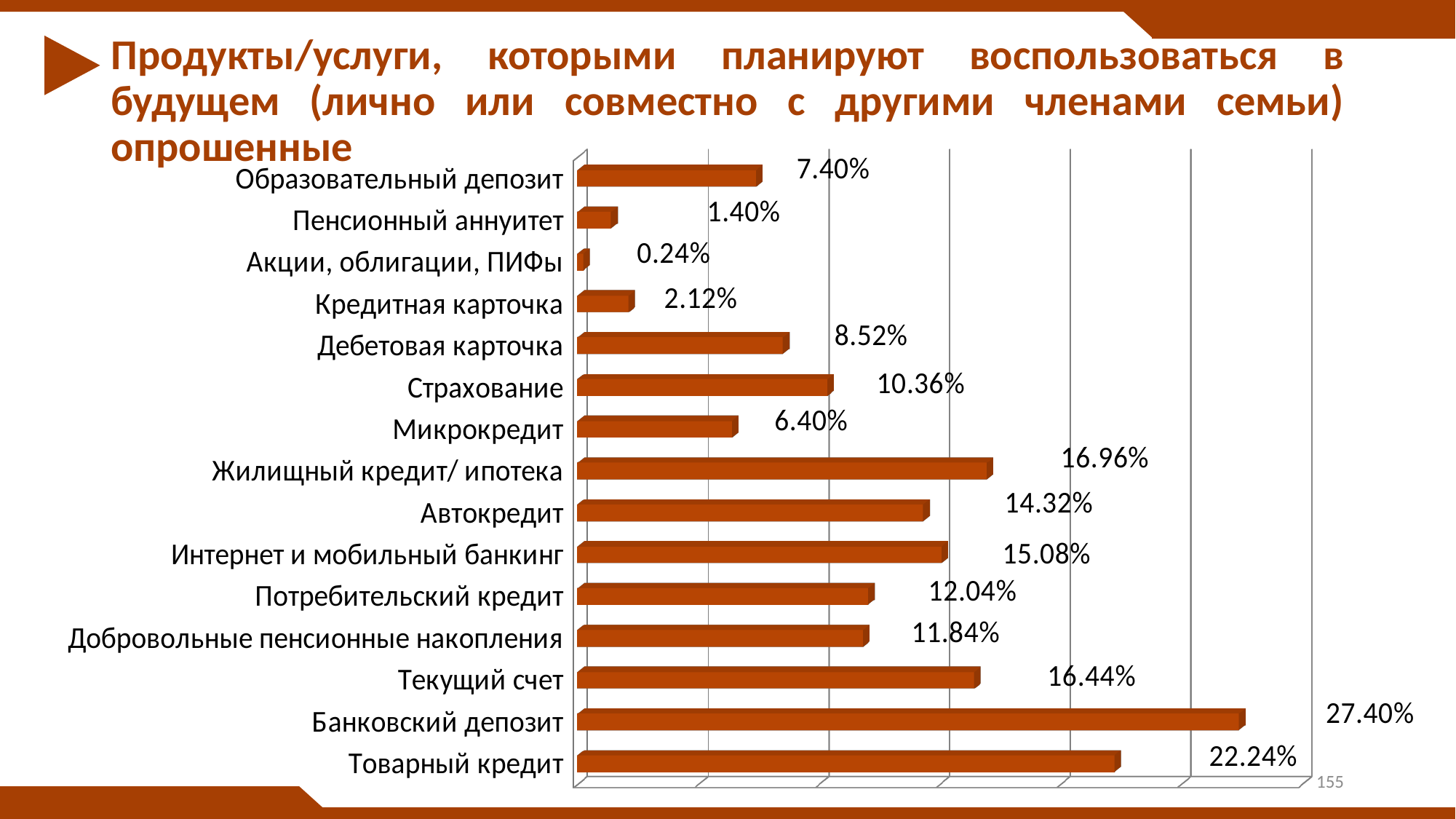
What is the difference between the values for Банковский депозит and Товарный кредит? 5.16% How many categories are plotted in the chart? 15 What is the value for Страхование? 10.36% What is the value for Жилищный кредит/ ипотека? 16.96% What is the difference between the values for Жилищный кредит/ ипотека and Текущий счет? 0.52% Which category has the highest value? Банковский депозит What is the value for Банковский депозит? 27.40% What kind of chart is shown on the slide? Bar chart Which is larger, the value for Автокредит or the value for Интернет и мобильный банкинг? Интернет и мобильный банкинг Which category has the lowest value? Акции, облигации, ПИФы What is the value for Акции, облигации, ПИФы? 0.24% Which is larger, the value for Дебетовая карточка or the value for Микрокредит? Дебетовая карточка